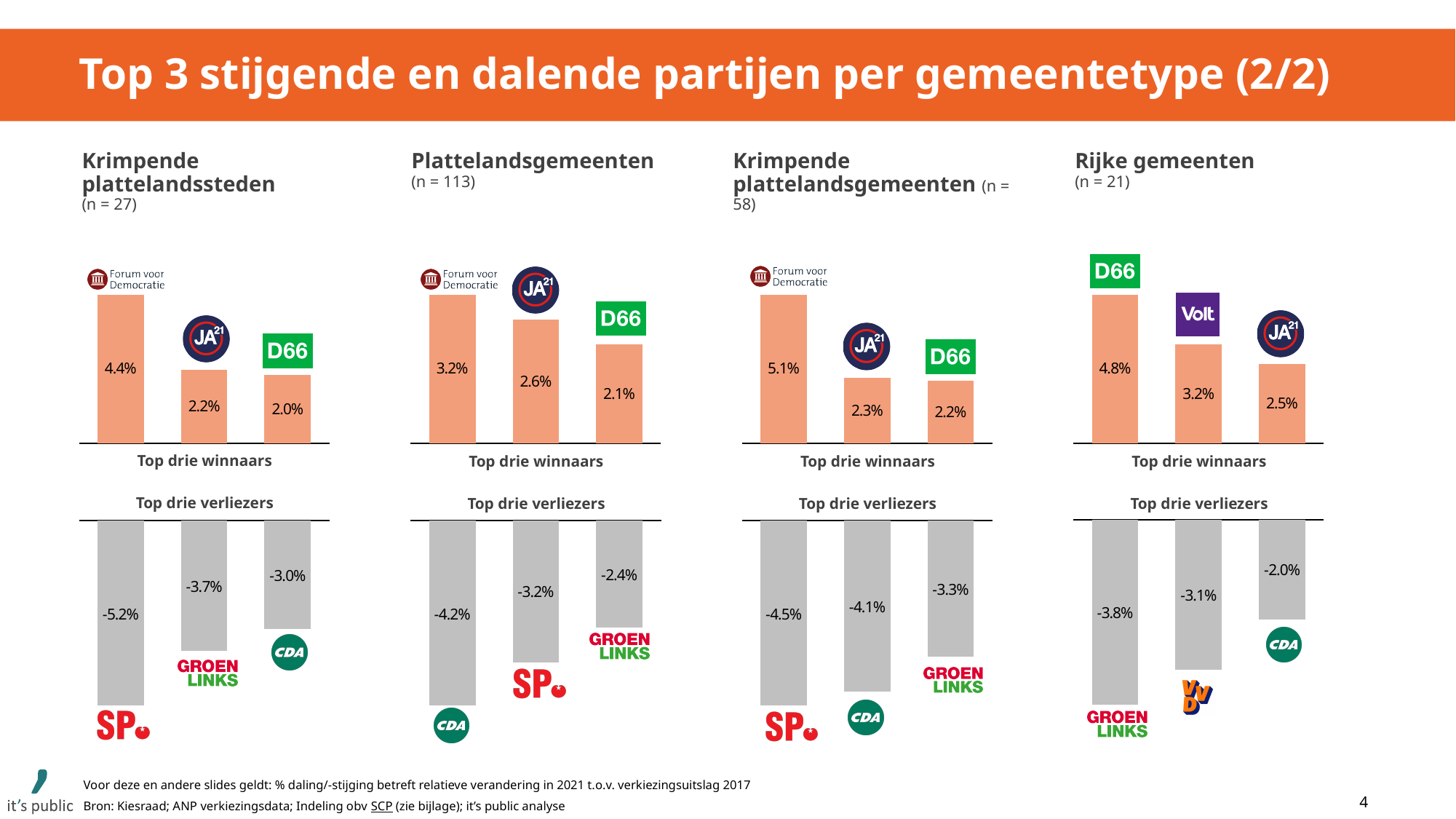
In the 'Top drie verliezers' chart for Plattelandsgemeenten, which party has the largest decline? CDA In the 'Top drie winnaars' chart for Krimpende plattelandssteden, which is larger: the value for JA21 or the value for D66? JA21 In the 'Top drie winnaars' chart for Rijke gemeenten, which party has the highest value? D66 In the 'Top drie winnaars' chart for Krimpende plattelandsgemeenten, what is the value for Forum voor Democratie? 5.1% In the 'Top drie winnaars' chart for Plattelandsgemeenten, what is the value for JA21? 2.6% In the 'Top drie verliezers' chart for Krimpende plattelandssteden, what is the value for SP? -5.2% In the 'Top drie winnaars' chart for Krimpende plattelandssteden, what is the value for Forum voor Democratie? 4.4% In the 'Top drie verliezers' chart for Rijke gemeenten, what is the value for VVD? -3.1% What type of chart is used for the 'Top drie winnaars' for Plattelandsgemeenten? Bar chart In the 'Top drie winnaars' chart for Rijke gemeenten, what is the difference between the values for D66 and Volt? 1.6% How many bars are shown in the 'Top drie verliezers' chart for Krimpende plattelandsgemeenten? 3 In the 'Top drie verliezers' chart for Krimpende plattelandsgemeenten, what is the difference between the values for SP and GroenLinks? 1.2%